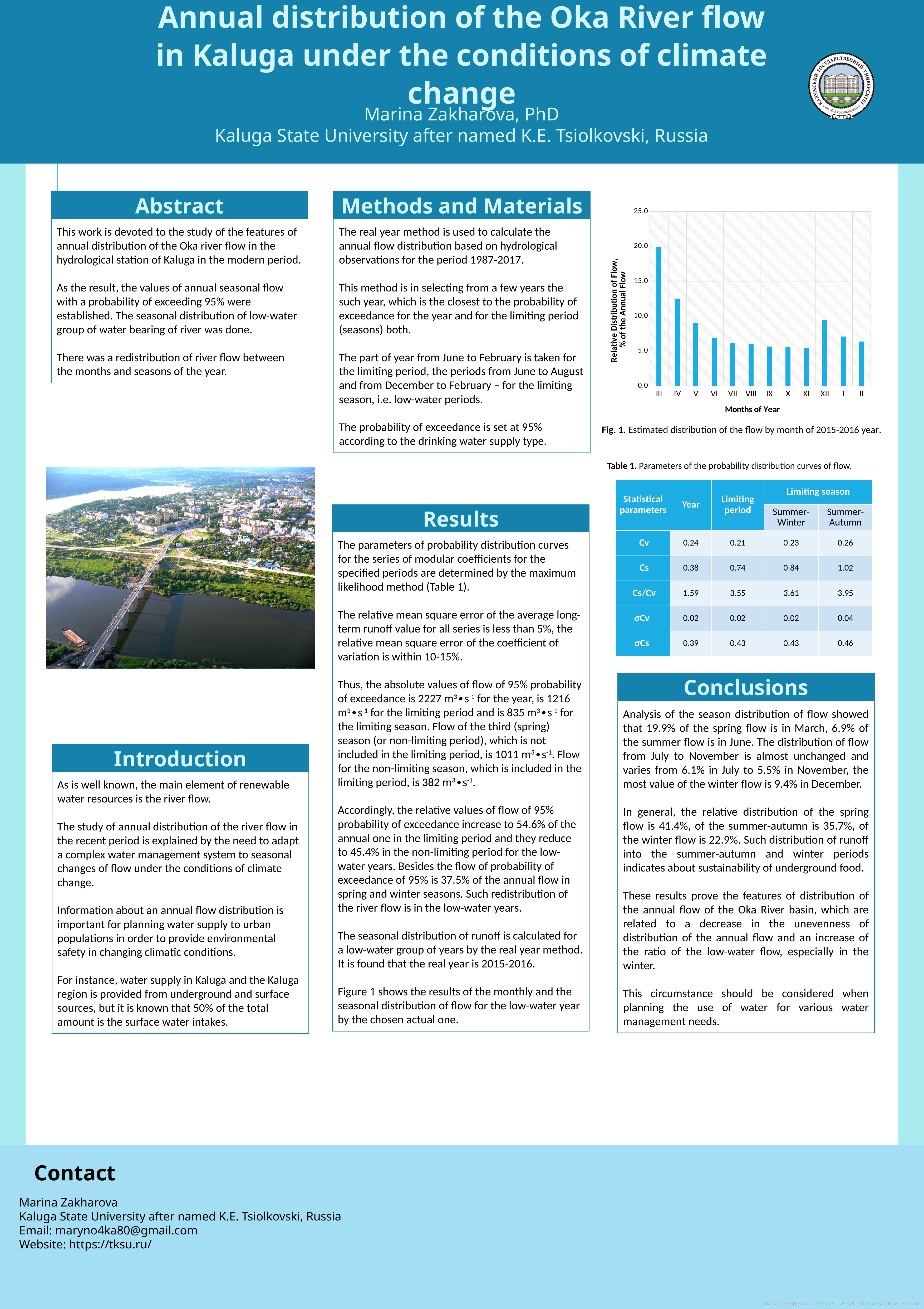
Which month has the highest relative distribution of flow in the chart? III Is the value for month V greater or less than 10.0? less Is the value for month IV greater or less than 10.0? greater How many months are plotted on the x axis of the chart? 12 Do the values rise or fall from month III to month XI along the x axis? fall What is the title of the x axis of the chart? Months of Year What kind of chart is shown in Fig. 1? bar chart Which is larger, the value for month XII or the value for month VI? XII Which is larger, the value for month III or the value for month IV? III Is the value for month XII greater or less than 5.0? greater